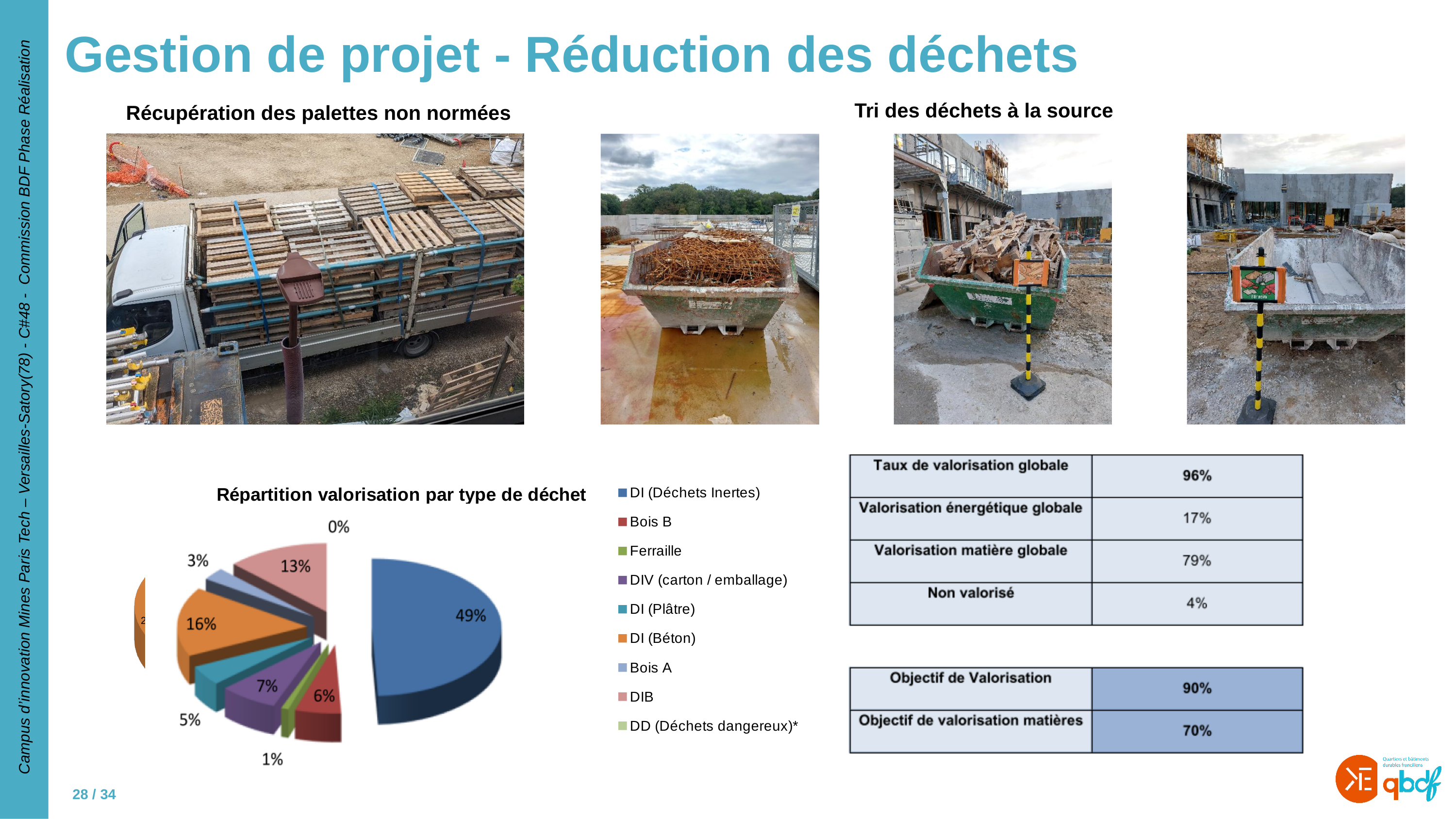
What share of the pie does DIB represent? 13% What is the difference between the shares of DI (Déchets Inertes) and DI (Béton)? 33% What share of the pie does Bois B represent? 6% Which has a larger share of the pie, DI (Plâtre) or DIV (carton / emballage)? DIV (carton / emballage) Which category has the smallest share of the pie? DD (Déchets dangereux)* What is the title of the pie chart? Répartition valorisation par type de déchet What share of the pie does DI (Déchets Inertes) represent? 49% Which category has the largest share of the pie? DI (Déchets Inertes) How many categories does the legend of the pie chart list? 9 What kind of chart is shown on the slide? pie chart